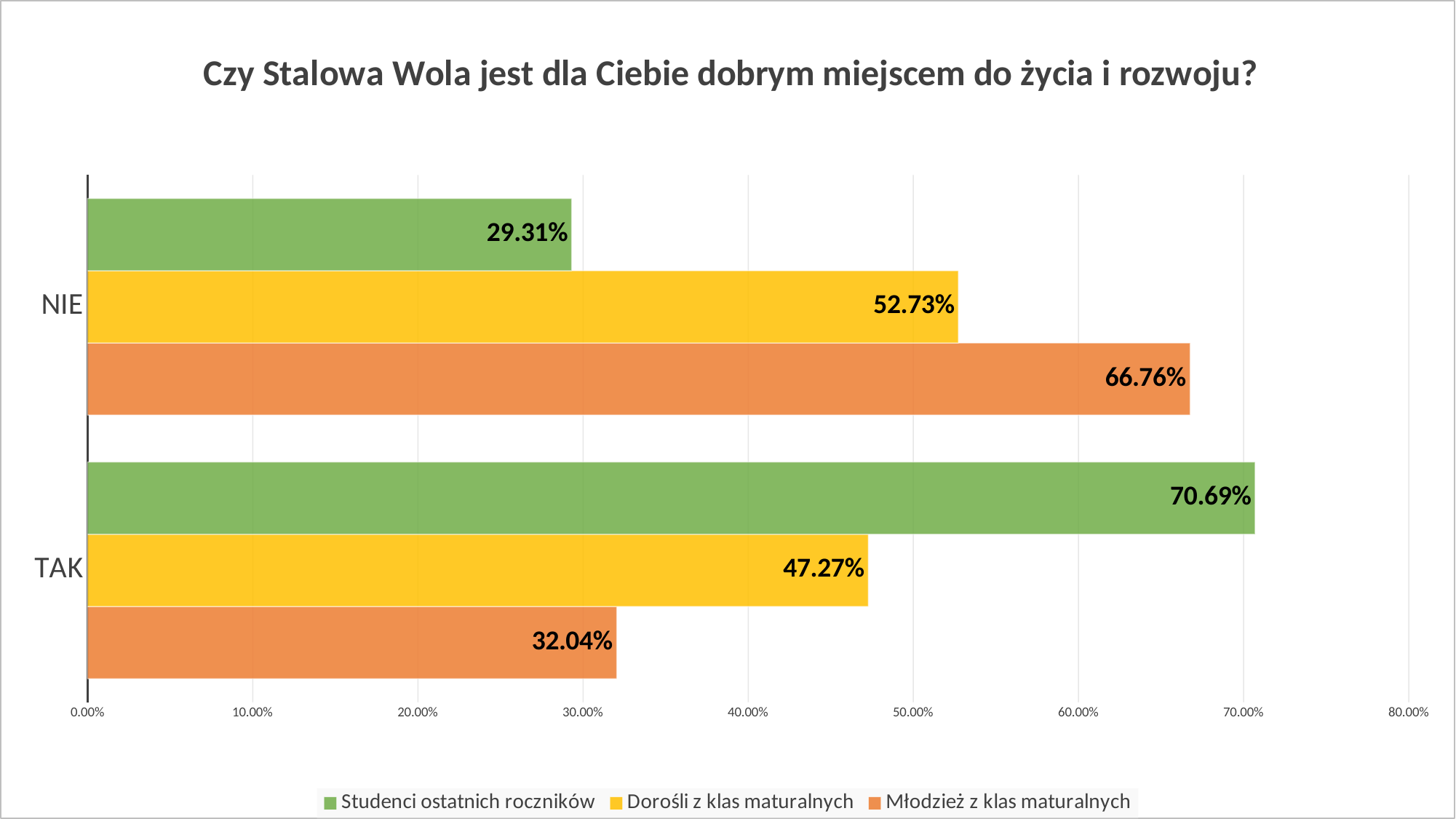
Which series has the highest value in the NIE category? Młodzież z klas maturalnych Which is larger: the TAK value for Dorośli z klas maturalnych or the TAK value for Młodzież z klas maturalnych? Dorośli z klas maturalnych How many answer categories are shown on the vertical axis? 2 Which series has the lowest value in the TAK category? Młodzież z klas maturalnych What is the difference between the NIE values for Młodzież z klas maturalnych and Dorośli z klas maturalnych? 14.03% What is the difference between the TAK and NIE values for Studenci ostatnich roczników? 41.38% What percentage of Studenci ostatnich roczników answered TAK? 70.69% What is the value for Dorośli z klas maturalnych in the TAK category? 47.27% What kind of chart is shown on the slide? Bar chart What is the value for Młodzież z klas maturalnych in the NIE category? 66.76% How many series does the legend list? 3 What colour represents Dorośli z klas maturalnych in the chart? Yellow